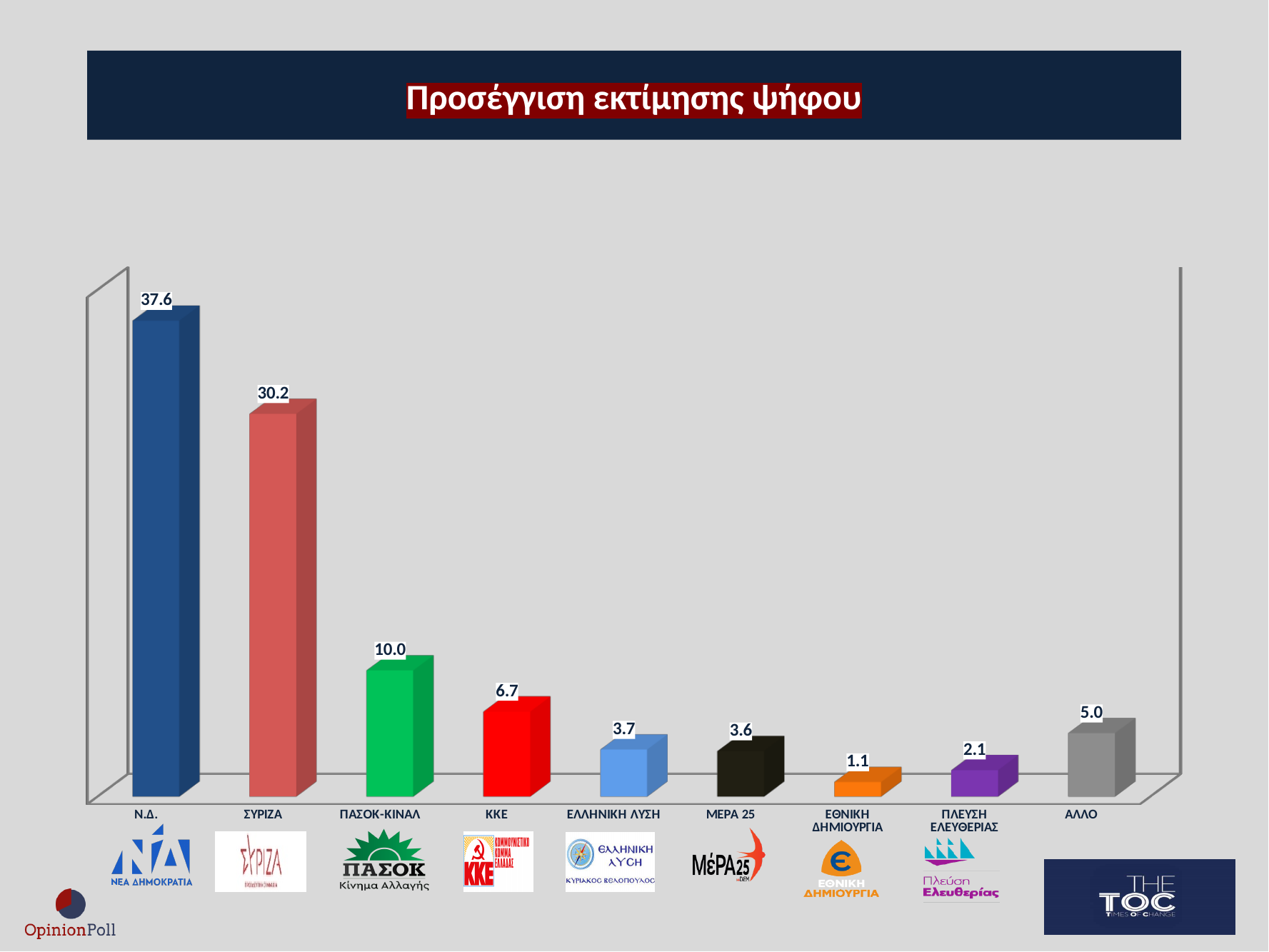
Which category has the highest value? Ν.Δ. What is the value for ΕΘΝΙΚΗ ΔΗΜΙΟΥΡΓΙΑ? 1.1 What is the value for ΠΑΣΟΚ-ΚΙΝΑΛ? 10.0 How many categories are shown in the chart? 9 Which is larger, the value for ΚΚΕ or the value for ΑΛΛΟ? ΚΚΕ What is the difference between the values for Ν.Δ. and ΣΥΡΙΖΑ? 7.4 Which category has the lowest value? ΕΘΝΙΚΗ ΔΗΜΙΟΥΡΓΙΑ What is the title of the chart? Προσέγγιση εκτίμησης ψήφου What is the value for Ν.Δ.? 37.6 What is the value for ΣΥΡΙΖΑ? 30.2 What kind of chart is shown on the slide? Bar chart What colour is the bar for ΠΛΕΥΣΗ ΕΛΕΥΘΕΡΙΑΣ? Purple